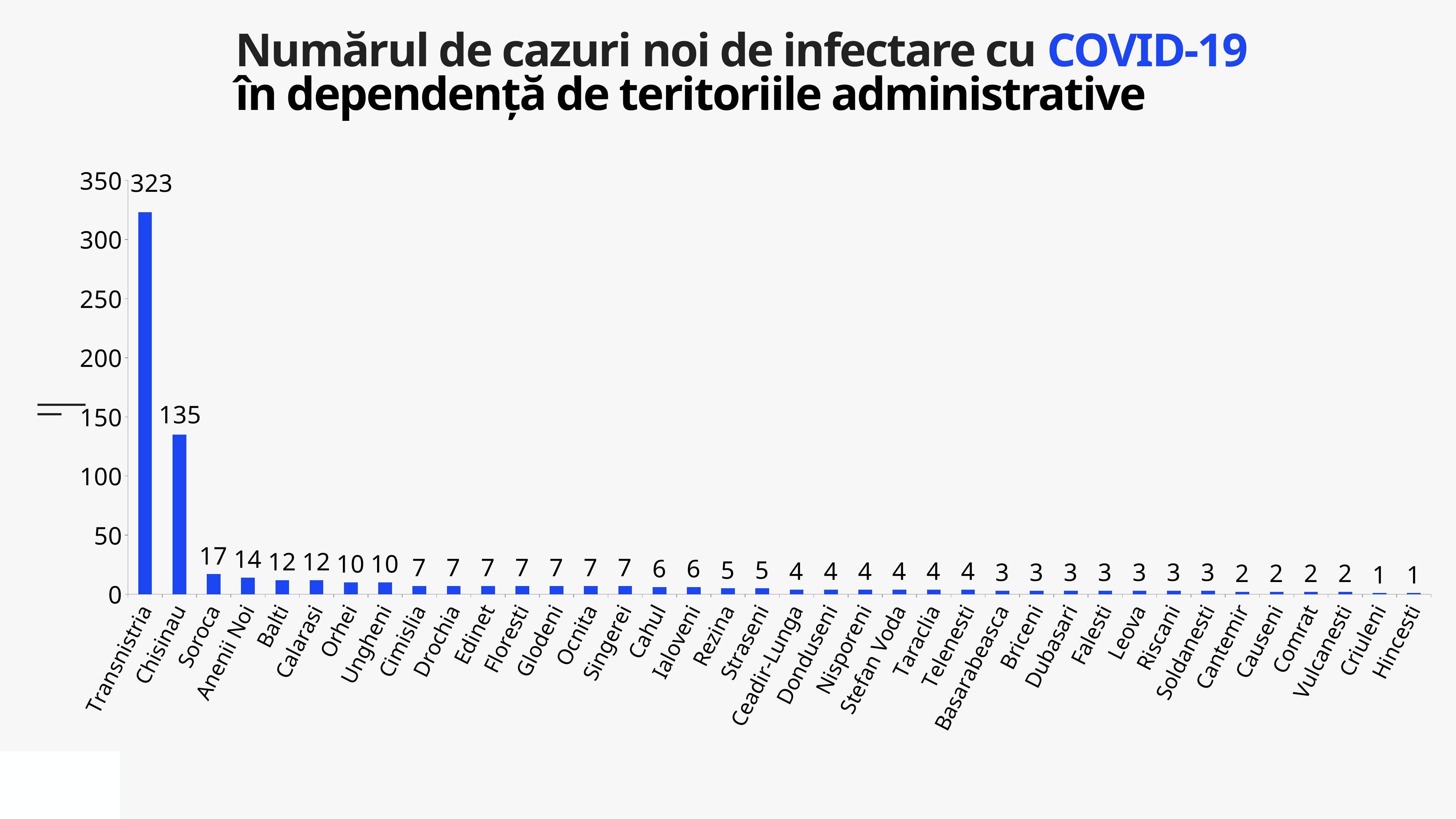
Which has a larger value, Soroca or Balti? Soroca What is the value for Anenii Noi? 14 What is the value for Cahul? 6 What is the value for Transnistria? 323 What is the value for Soroca? 17 Which territory has the highest number of new cases? Transnistria How many territories are shown on the chart? 38 Do the values rise or fall from left to right along the x axis? fall What kind of chart is this? bar chart What is the difference between the values for Transnistria and Chisinau? 188 What is the value for Chisinau? 135 Is the value for Chisinau greater or less than 150? less